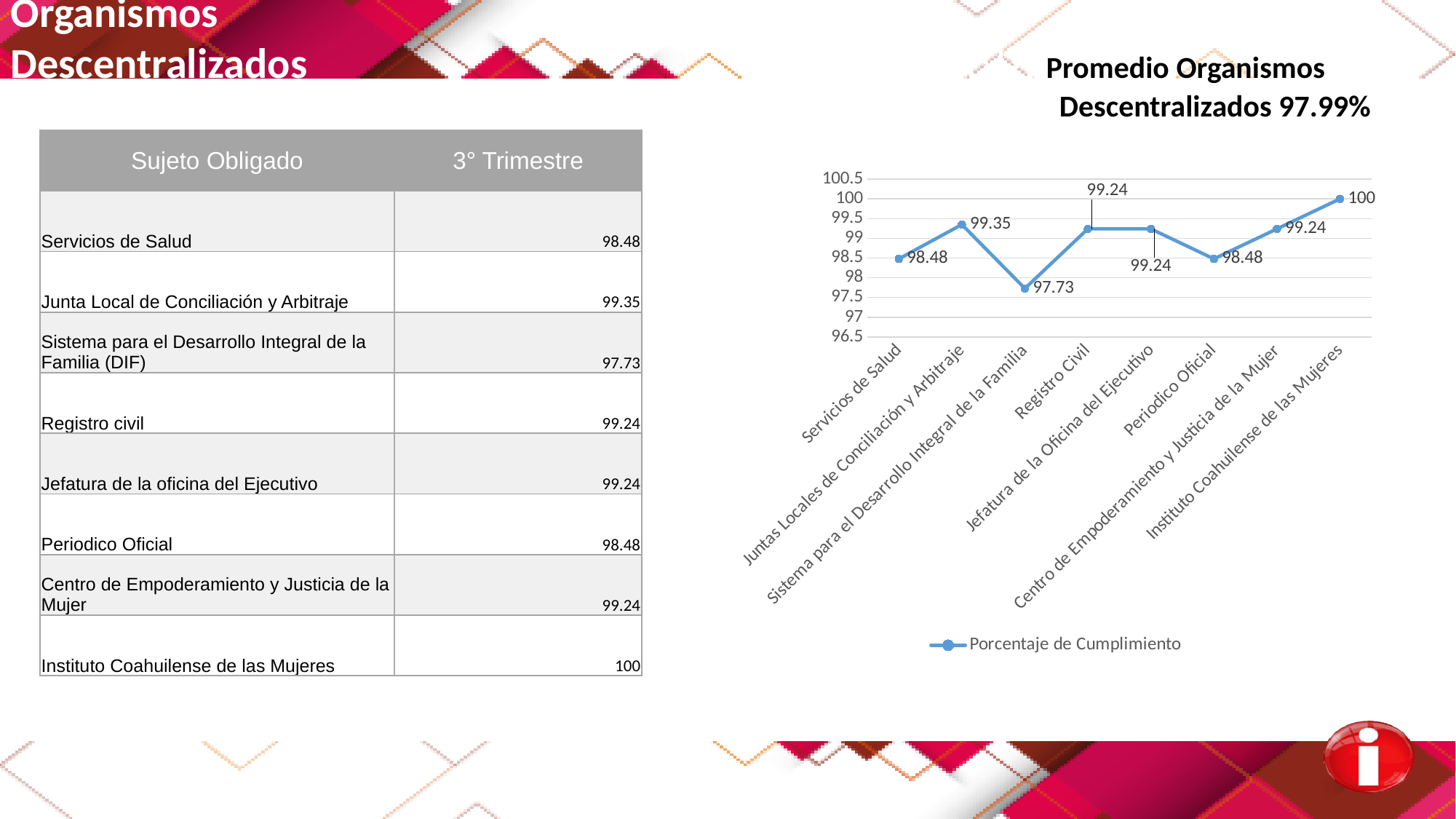
Which category has the highest value in the chart? Instituto Coahuilense de las Mujeres What is the value for Servicios de Salud in the chart? 98.48 Which category has the lowest value in the chart? Sistema para el Desarrollo Integral de la Familia What is the value for Sistema para el Desarrollo Integral de la Familia in the chart? 97.73 How many categories are plotted on the x axis of the chart? 8 What type of chart is shown on the slide? line chart Which is larger, the value for Juntas Locales de Conciliación y Arbitraje or the value for Periodico Oficial? Juntas Locales de Conciliación y Arbitraje How many series does the chart legend list? 1 What is the value for Juntas Locales de Conciliación y Arbitraje in the chart? 99.35 What is the difference between the values for Instituto Coahuilense de las Mujeres and Sistema para el Desarrollo Integral de la Familia? 2.27 What is the value for Instituto Coahuilense de las Mujeres in the chart? 100 What is the name of the series shown in the chart legend? Porcentaje de Cumplimiento